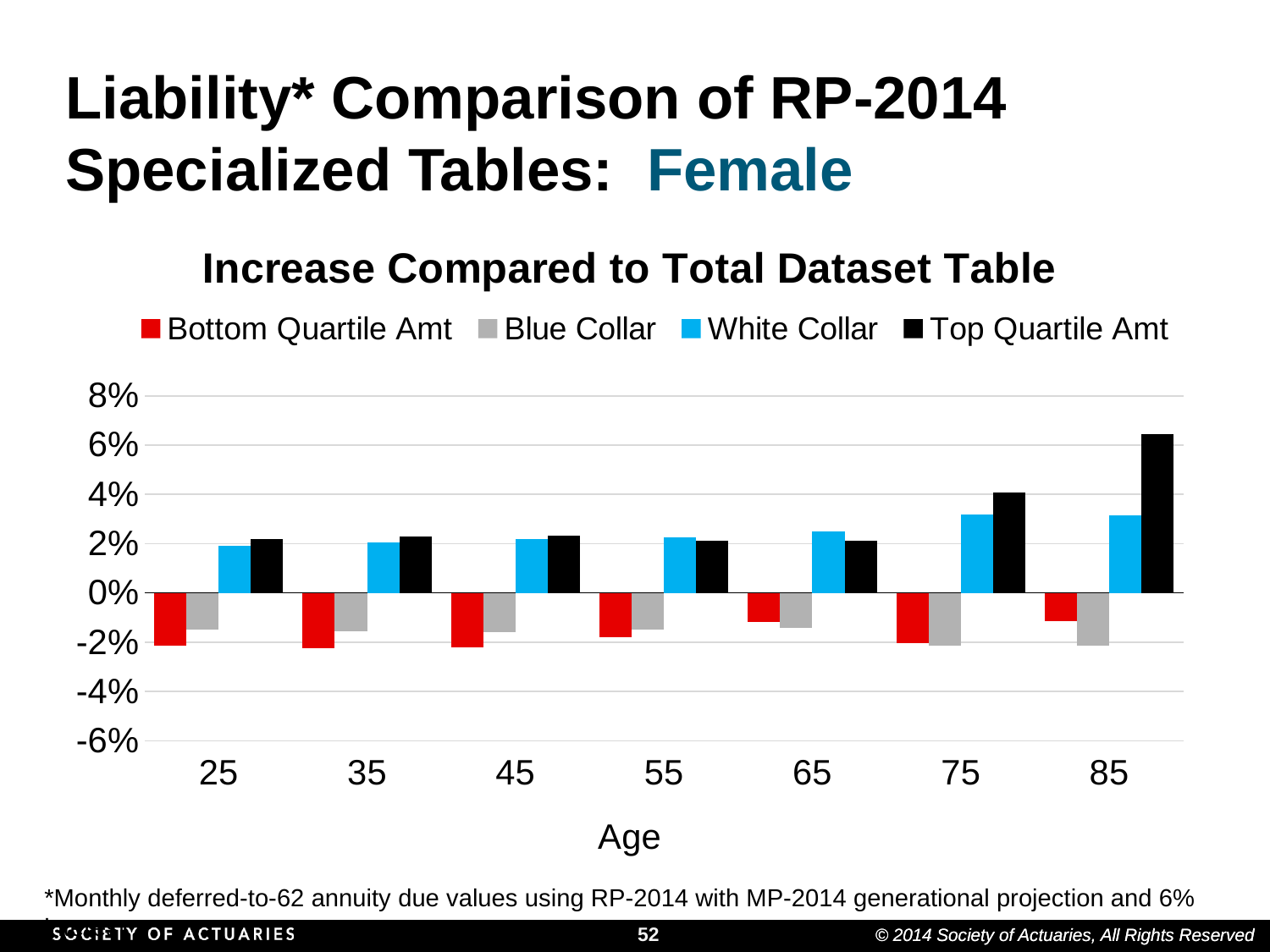
From age 65 to age 85, does the Top Quartile Amt series rise or fall? Rise How many series does the legend list? 4 What is the title of the chart? Increase Compared to Total Dataset Table At which age does the Top Quartile Amt series reach its highest value? 85 How many age categories are shown on the x axis? 7 Is the value for Top Quartile Amt at age 85 greater or less than 4%? greater Which series has the tallest bar at age 85? Top Quartile Amt Is the value for Bottom Quartile Amt at age 25 greater or less than 0%? less What kind of chart is shown on the slide? Bar chart At age 85, which is larger: Top Quartile Amt or White Collar? Top Quartile Amt Is the value for White Collar at age 75 greater or less than 2%? greater At age 75, which is larger: Top Quartile Amt or White Collar? Top Quartile Amt